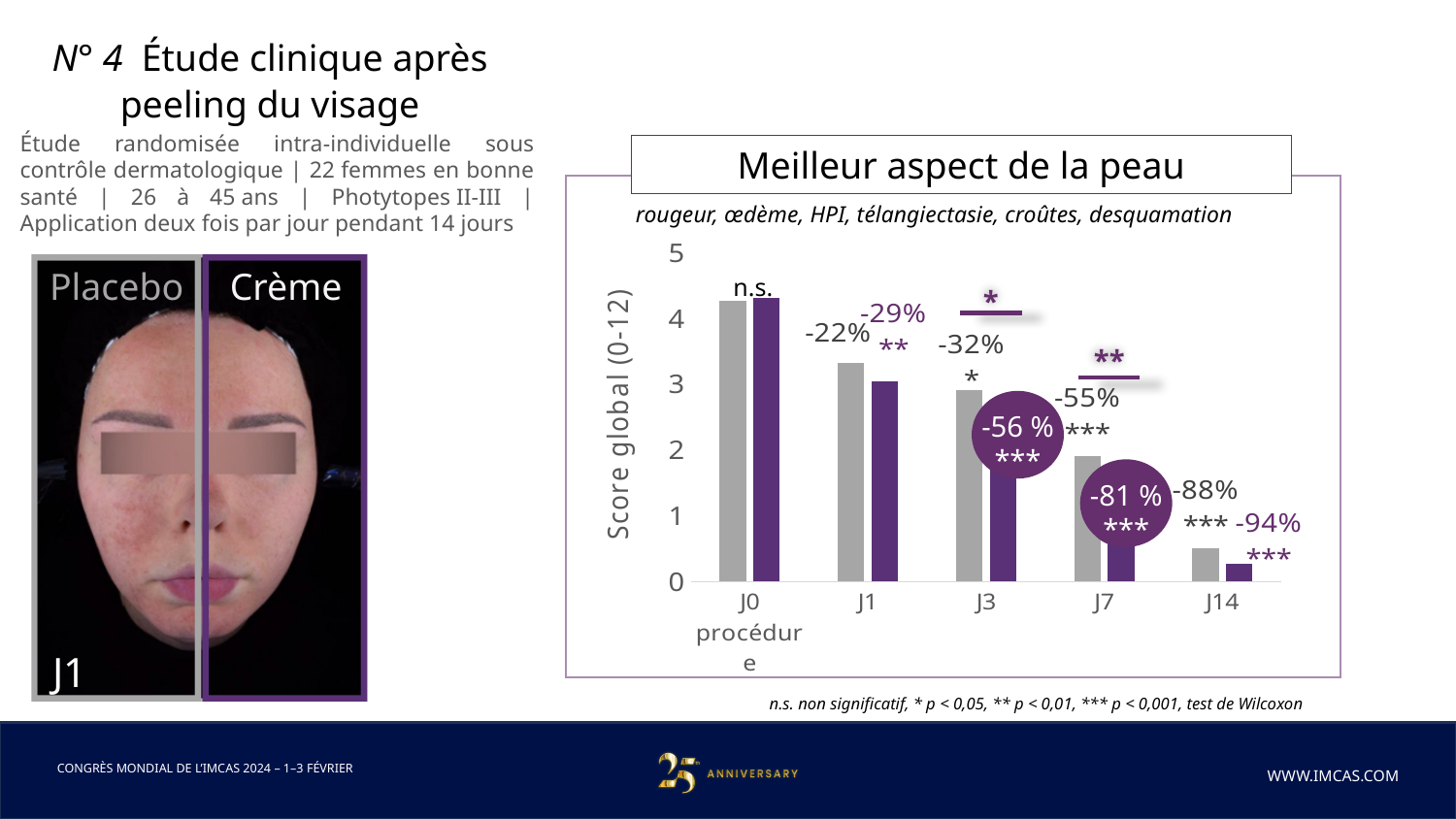
What is the title of the chart? Meilleur aspect de la peau What percentage change is labelled in purple above the J14 bars in the chart? -94% Is the value of the grey bar at J1 greater or less than 3? greater At which time point are the bars lowest in the chart? J14 At which time point are the bars highest in the chart? J0 procédure Do the bar values rise or fall from J0 to J14 in the chart? fall How many time-point categories are shown on the x axis of the chart? 5 Is the value of the grey bar at J0 greater or less than 4? greater What kind of chart is shown on the slide? bar chart How many bars are plotted for each time point in the chart? 2 What is the label of the vertical axis of the chart? Score global (0-12) Is the value of the purple bar at J14 greater or less than 1? less